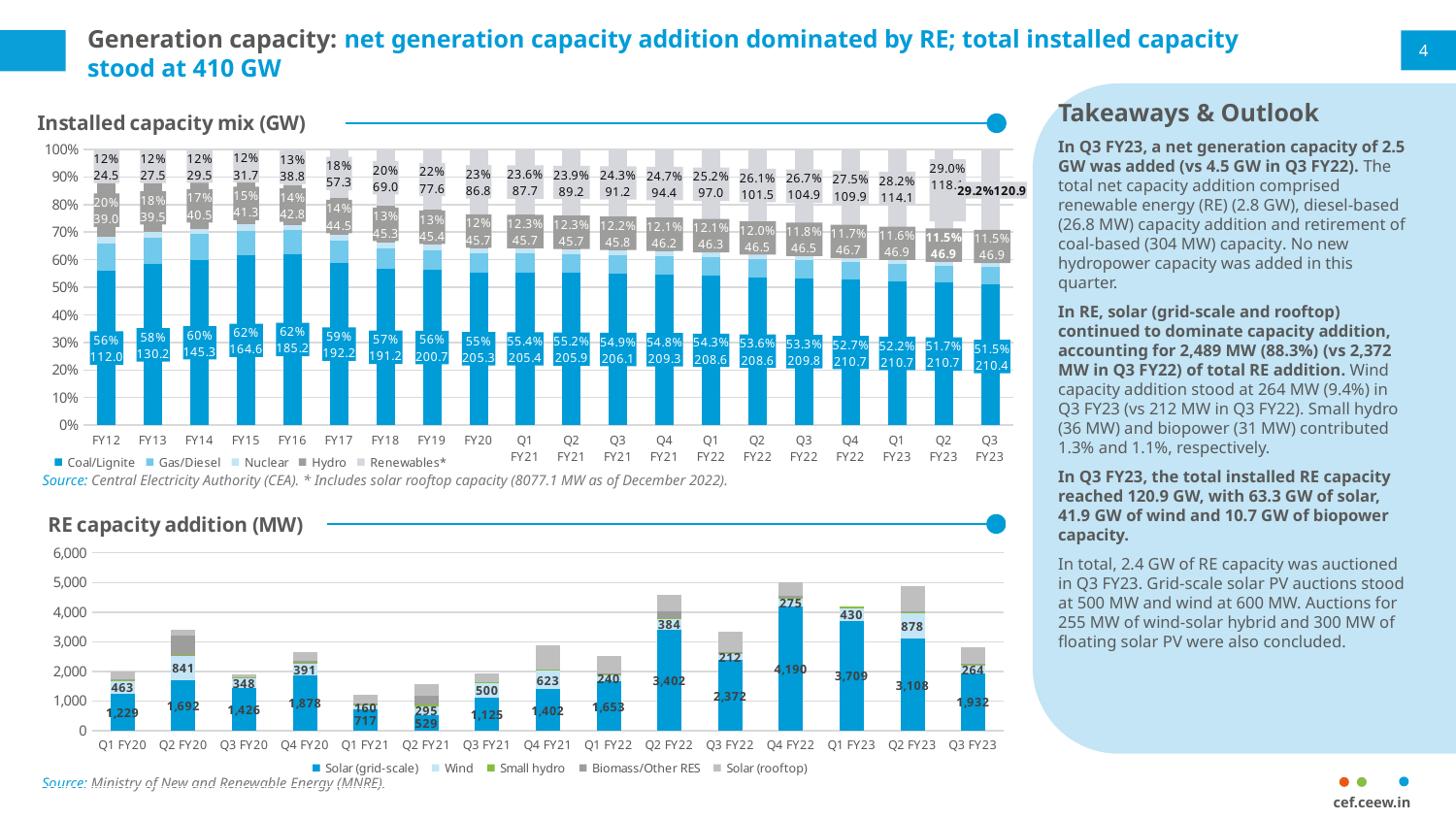
In the 'Installed capacity mix (GW)' chart, what is the difference in Renewables capacity (GW) between Q3 FY23 and Q2 FY23? 2.8 In the 'RE capacity addition (MW)' chart, which quarter has the highest Wind addition? Q2 FY23 In the 'Installed capacity mix (GW)' chart, does the Coal/Lignite share rise or fall from FY16 to Q3 FY23? fall In the 'Installed capacity mix (GW)' chart, what is the Renewables capacity in GW shown for FY18? 69.0 In the 'RE capacity addition (MW)' chart, what is the Solar (grid-scale) addition in Q4 FY22? 4,190 In the 'RE capacity addition (MW)' chart, which quarter has the lowest Solar (grid-scale) addition? Q2 FY21 In the 'RE capacity addition (MW)' chart, is the Solar (grid-scale) addition in Q1 FY23 larger or smaller than in Q2 FY23? larger In the 'Installed capacity mix (GW)' chart, what share of installed capacity do Renewables account for in Q3 FY23? 29.2% In the 'Installed capacity mix (GW)' chart, what is the Coal/Lignite capacity shown for FY16? 185.2 What type of chart is the 'RE capacity addition (MW)' chart? stacked bar chart In the 'Installed capacity mix (GW)' chart, how many series does the legend list? 5 In the 'RE capacity addition (MW)' chart, how many quarters are shown on the x axis? 15